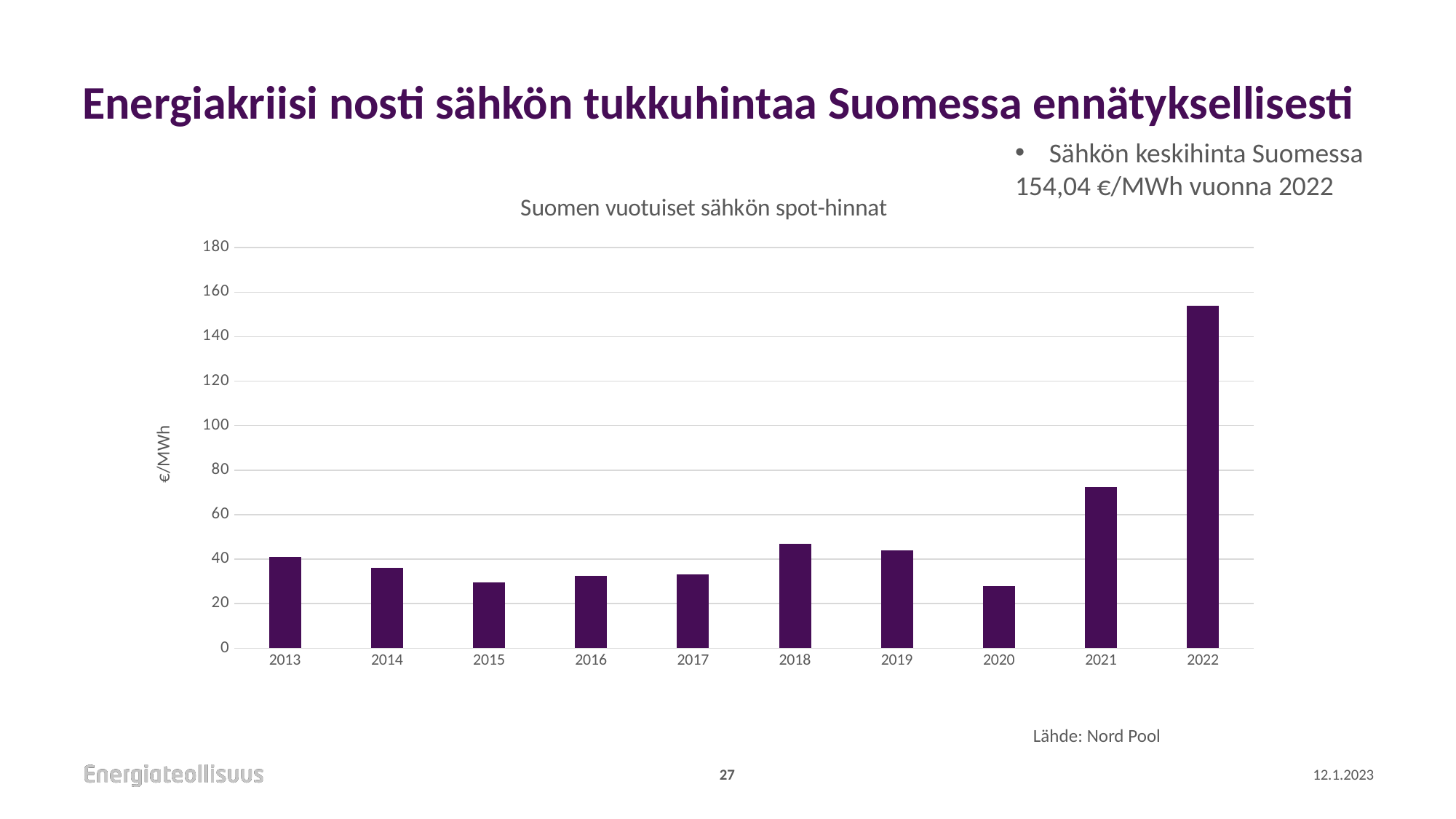
Which year has the highest spot price in the chart? 2022 What unit is shown on the y-axis label of the chart? €/MWh How many years are shown on the x axis of the chart? 10 Is the value for 2021 greater or less than 60? greater Is the value for 2022 greater or less than 140? greater What type of chart is shown on the slide? bar chart Do the values rise or fall from 2020 to 2022? rise Is the value for 2014 greater or less than 40? less Which year has the larger value, 2018 or 2021? 2021 What was the average electricity price in Finland in 2022, as stated on the slide? 154,04 €/MWh What is the title of the chart? Suomen vuotuiset sähkön spot-hinnat